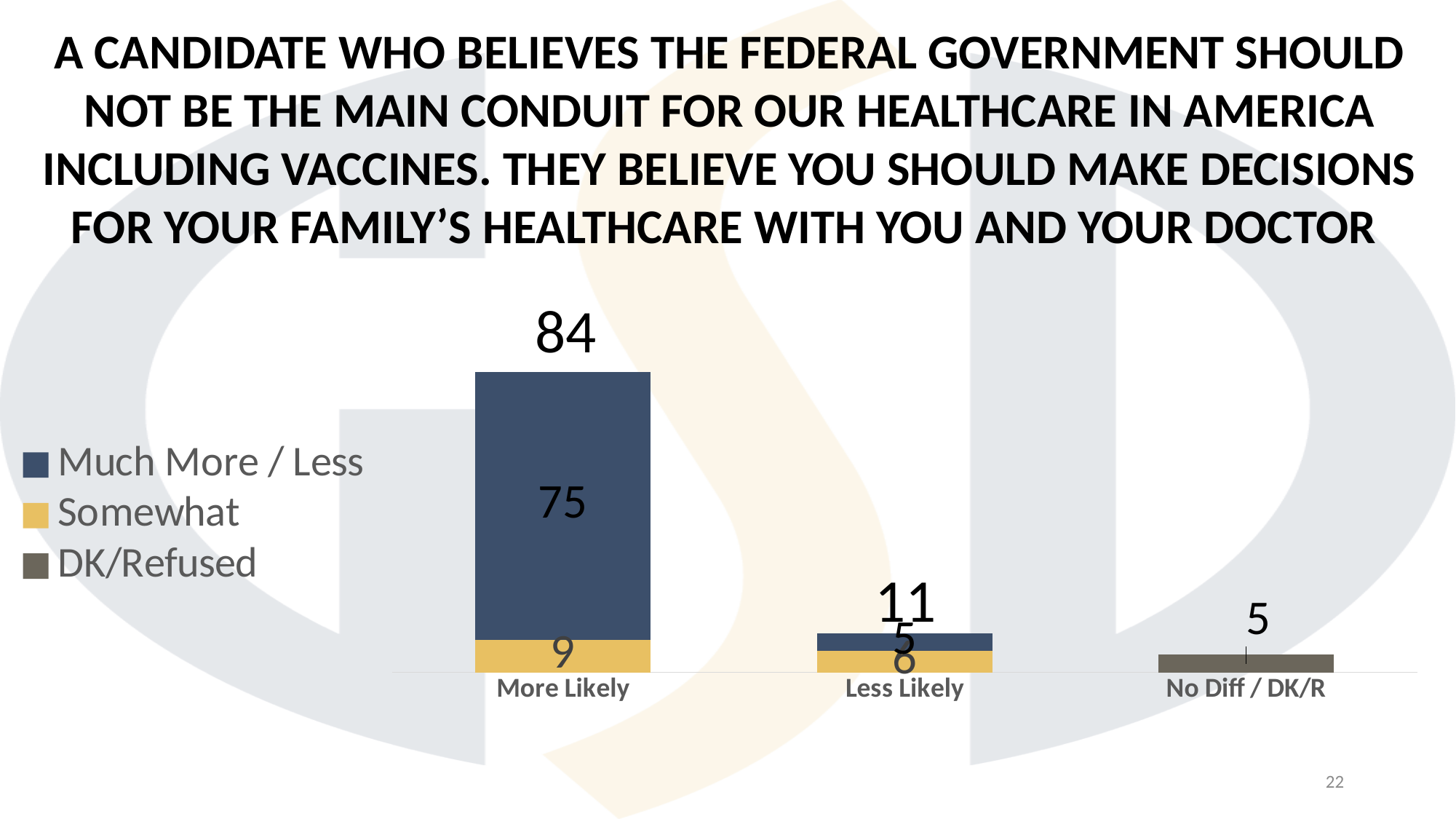
Which category has the lowest total? No Diff / DK/R What is the difference between the More Likely total and the Less Likely total? 73 What is the Somewhat value for More Likely? 9 What is the Much More / Less value for More Likely? 75 How many series does the legend list? 3 Which category has the highest total? More Likely What is the value for No Diff / DK/R? 5 What is the Somewhat value for Less Likely? 6 How many categories are shown on the x axis? 3 What is the total value shown above the More Likely bar? 84 What is the total value shown above the Less Likely bar? 11 Which is larger, the Much More / Less value for More Likely or the Somewhat value for More Likely? Much More / Less